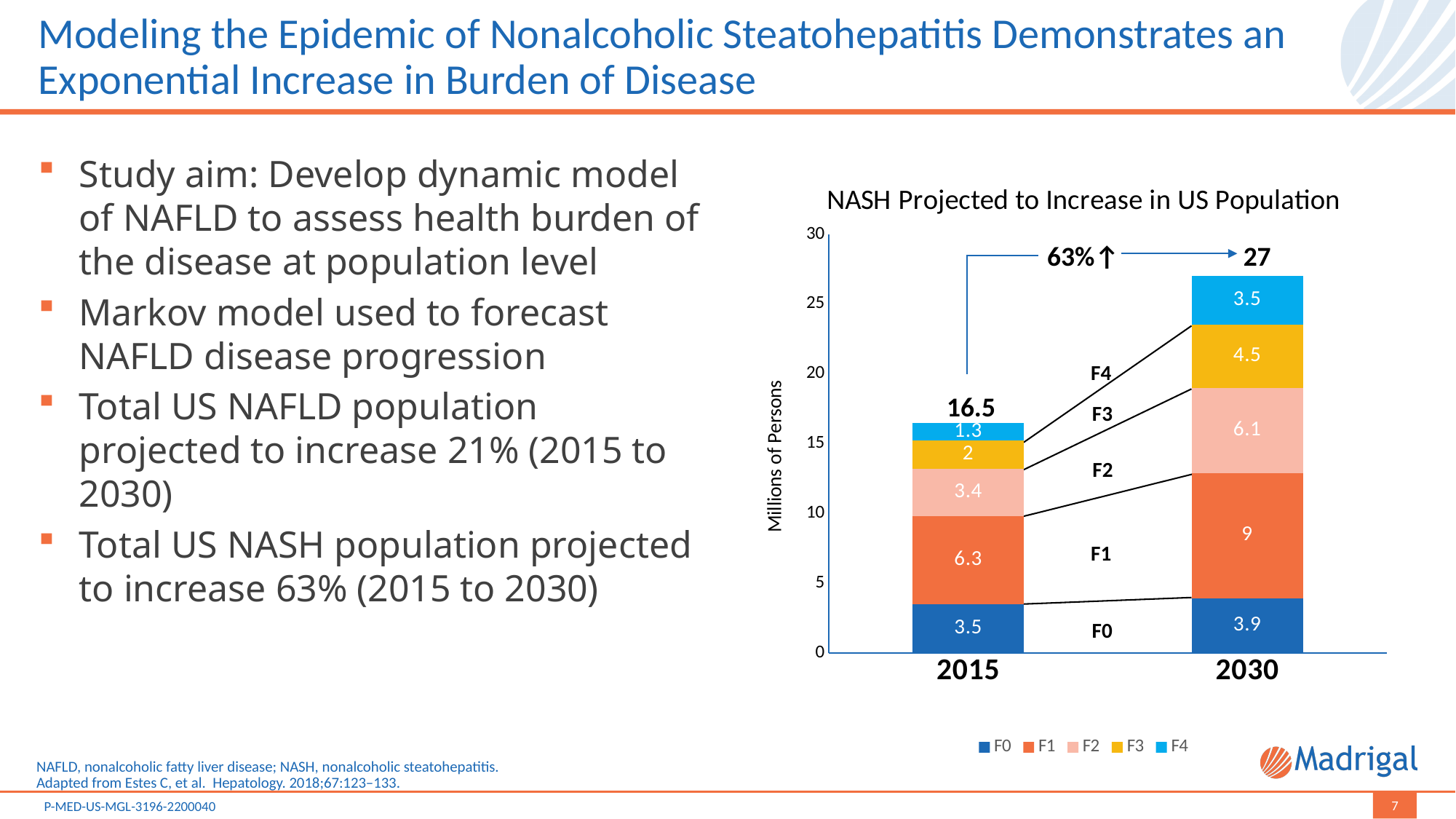
What is the total of the stacked bar for 2015? 16.5 What is the value of the F4 segment for 2030? 3.5 What is the title of the chart? NASH Projected to Increase in US Population What kind of chart is shown? Stacked bar chart Which segment is the smallest in the 2015 bar? F4 Which segment is the largest in the 2030 bar? F1 Which is larger, the F3 value for 2015 or the F3 value for 2030? 2030 What is the value of the F1 segment for 2015? 6.3 What is the value of the F2 segment for 2030? 6.1 What is the total of the stacked bar for 2030? 27 How many series does the legend list? 5 What is the difference between the F1 values for 2030 and 2015? 2.7